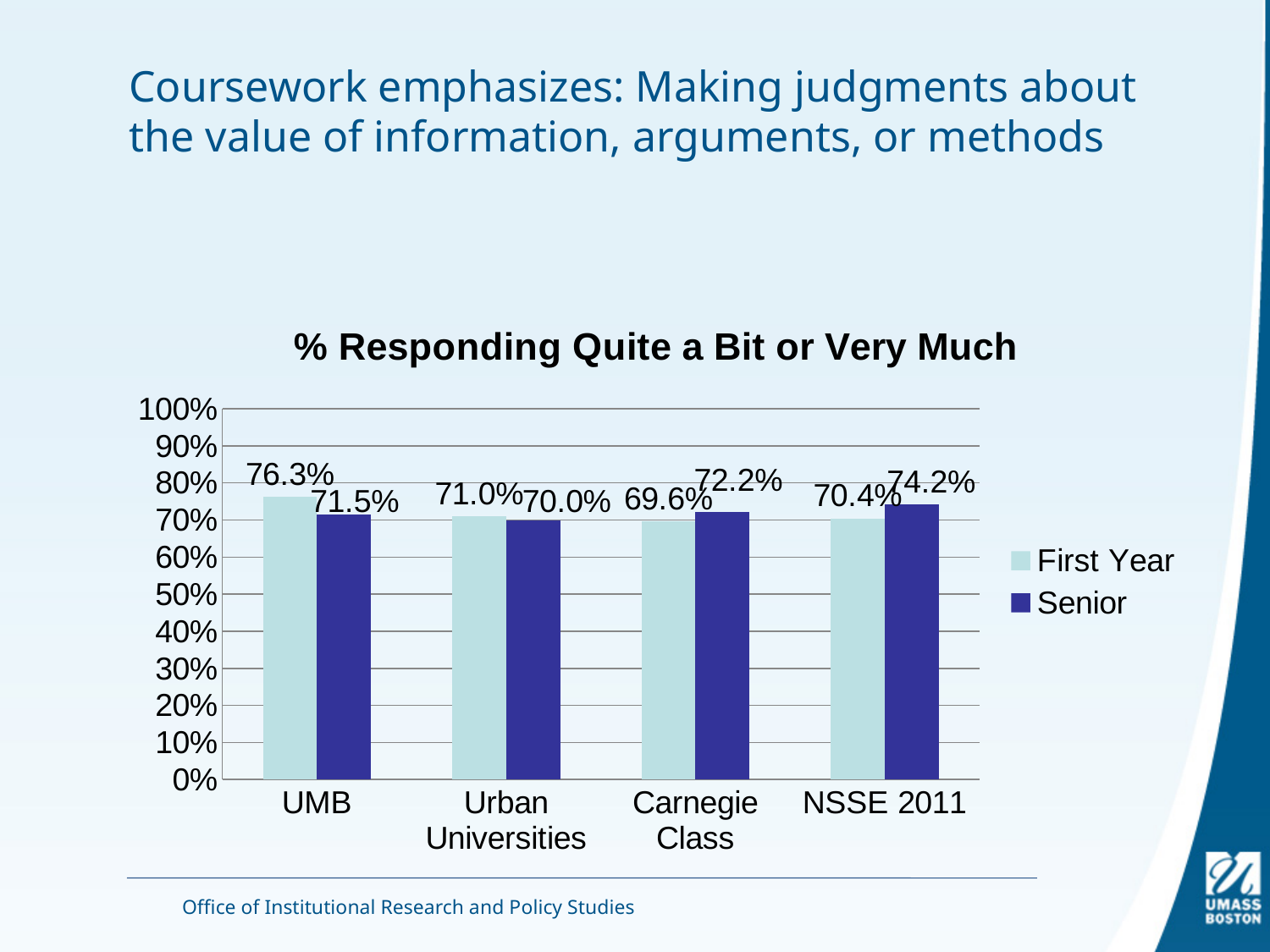
What is the title of the chart? % Responding Quite a Bit or Very Much Which category has the highest First Year value? UMB What is the First Year value for UMB? 76.3% What is the Senior value for NSSE 2011? 74.2% What kind of chart is shown on the slide? Bar chart How many series does the legend list? 2 What is the difference between the First Year and Senior values for UMB? 4.8% What is the Senior value for Urban Universities? 70.0% Which category has the lowest Senior value? Urban Universities How many categories are shown on the x axis? 4 Which is larger for Carnegie Class, the First Year value or the Senior value? Senior What is the First Year value for Carnegie Class? 69.6%